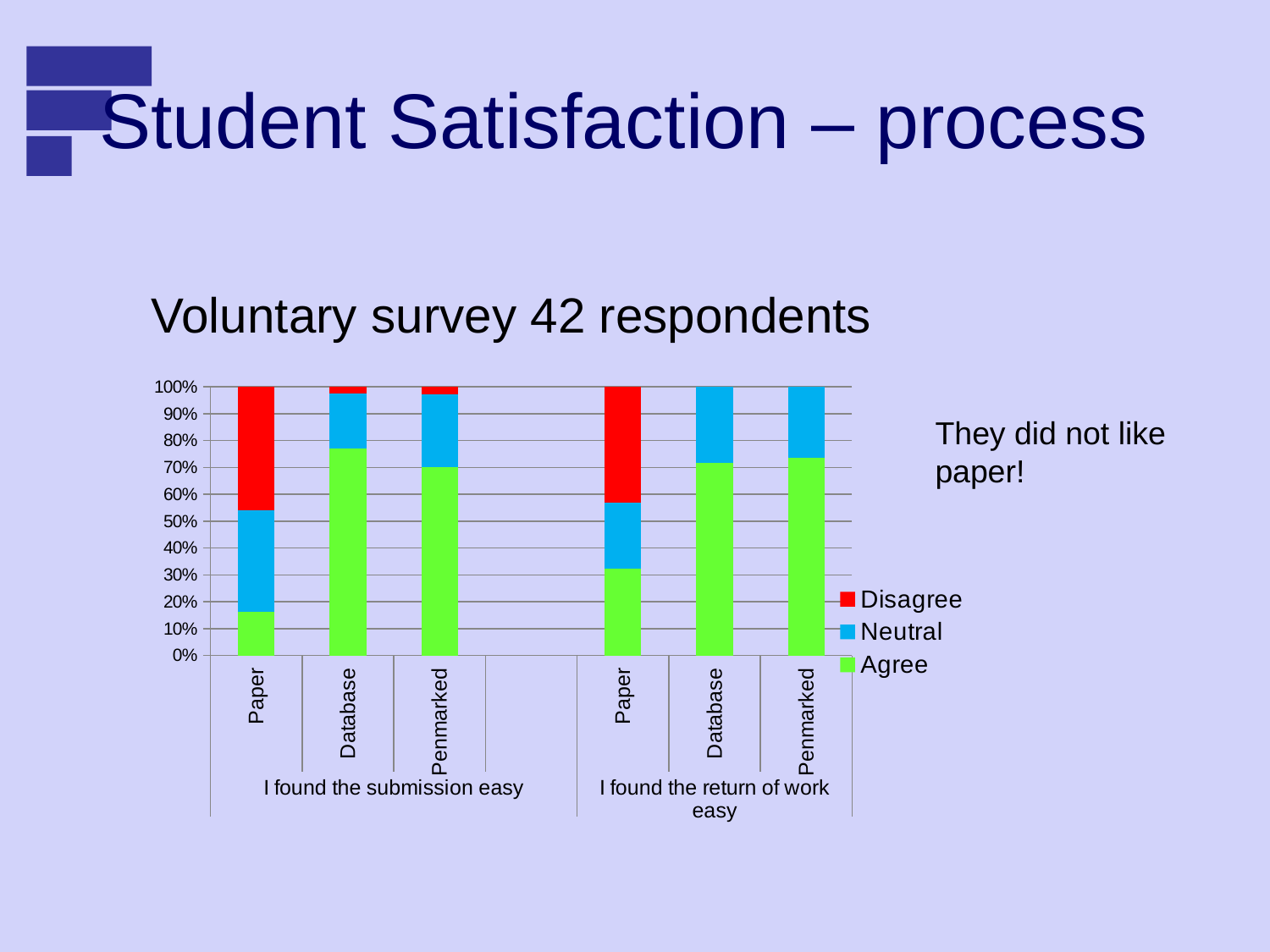
Under 'I found the return of work easy', which category has the largest Disagree share? Paper What are the two question groups labelled along the x axis? I found the submission easy; I found the return of work easy Under 'I found the submission easy', is the Agree share larger for Paper or for Penmarked? Penmarked Which series is shown in red in the legend? Disagree Is the Agree share for Paper under 'I found the return of work easy' greater or less than 40%? less Is the Agree share for Database under 'I found the submission easy' greater or less than 70%? greater Under 'I found the return of work easy', which category has the smallest Agree share? Paper What kind of chart is shown on the slide? Stacked bar chart How many series does the legend list? 3 Under 'I found the submission easy', which category has the largest Agree share? Database Is the Agree share for Paper under 'I found the submission easy' greater or less than 20%? less How many stacked bars are plotted in the chart? 6